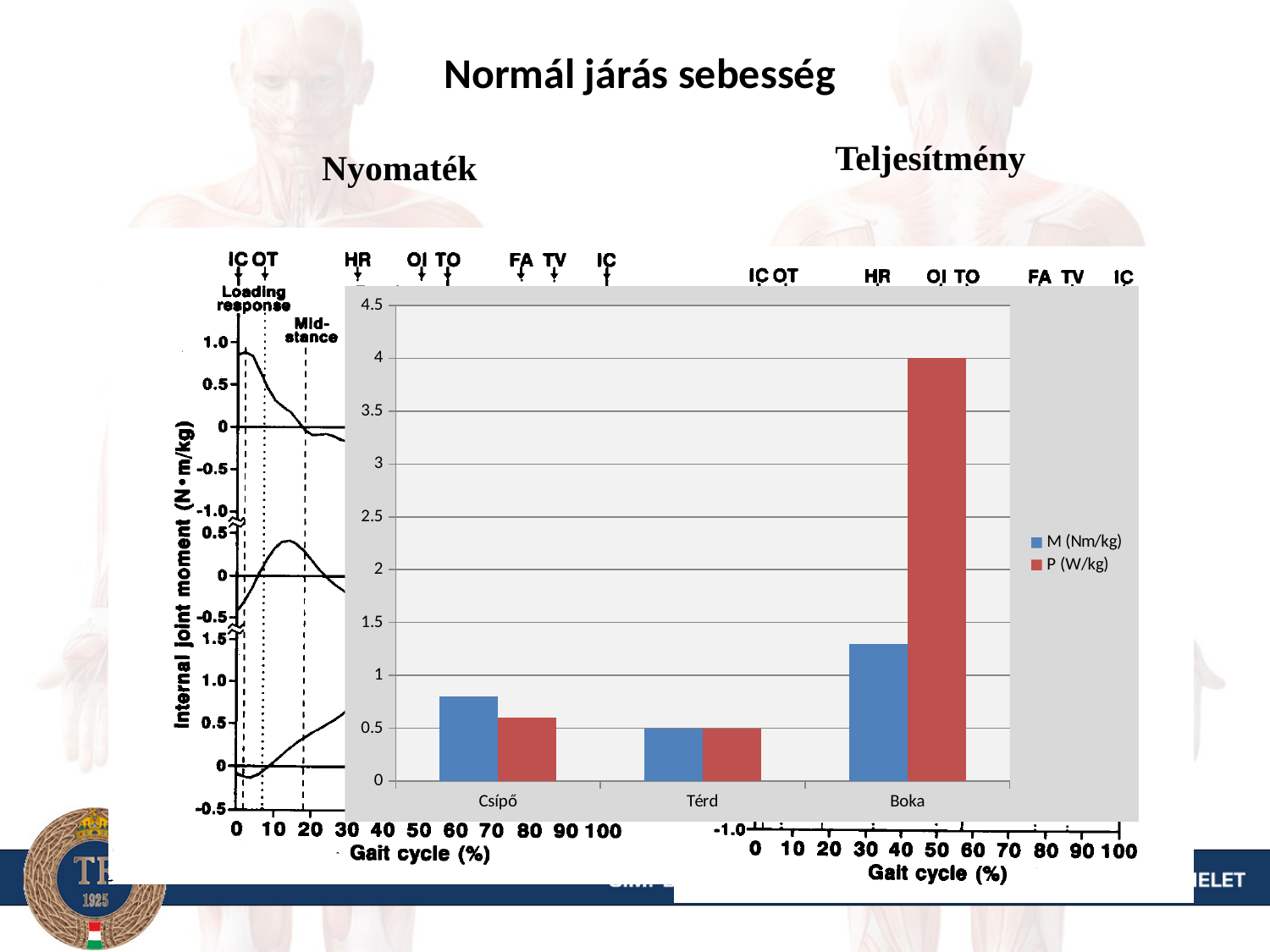
For Csípő in the bar chart, which is larger: M (Nm/kg) or P (W/kg)? M (Nm/kg) In the bar chart, is the P (W/kg) value for Boka greater or less than 3? greater In the bar chart, is the M (Nm/kg) value for Boka greater or less than 1? greater What kind of chart is shown on the slide? bar chart How many categories are shown on the x axis of the bar chart? 3 What are the two series names listed in the legend of the bar chart? M (Nm/kg) and P (W/kg) In the bar chart, is the M (Nm/kg) value for Csípő greater or less than 1? less For Boka in the bar chart, which is larger: M (Nm/kg) or P (W/kg)? P (W/kg) What colour are the P (W/kg) bars in the bar chart? red Which category has the highest M (Nm/kg) value in the bar chart? Boka How many series does the legend of the bar chart list? 2 Which category has the highest P (W/kg) value in the bar chart? Boka